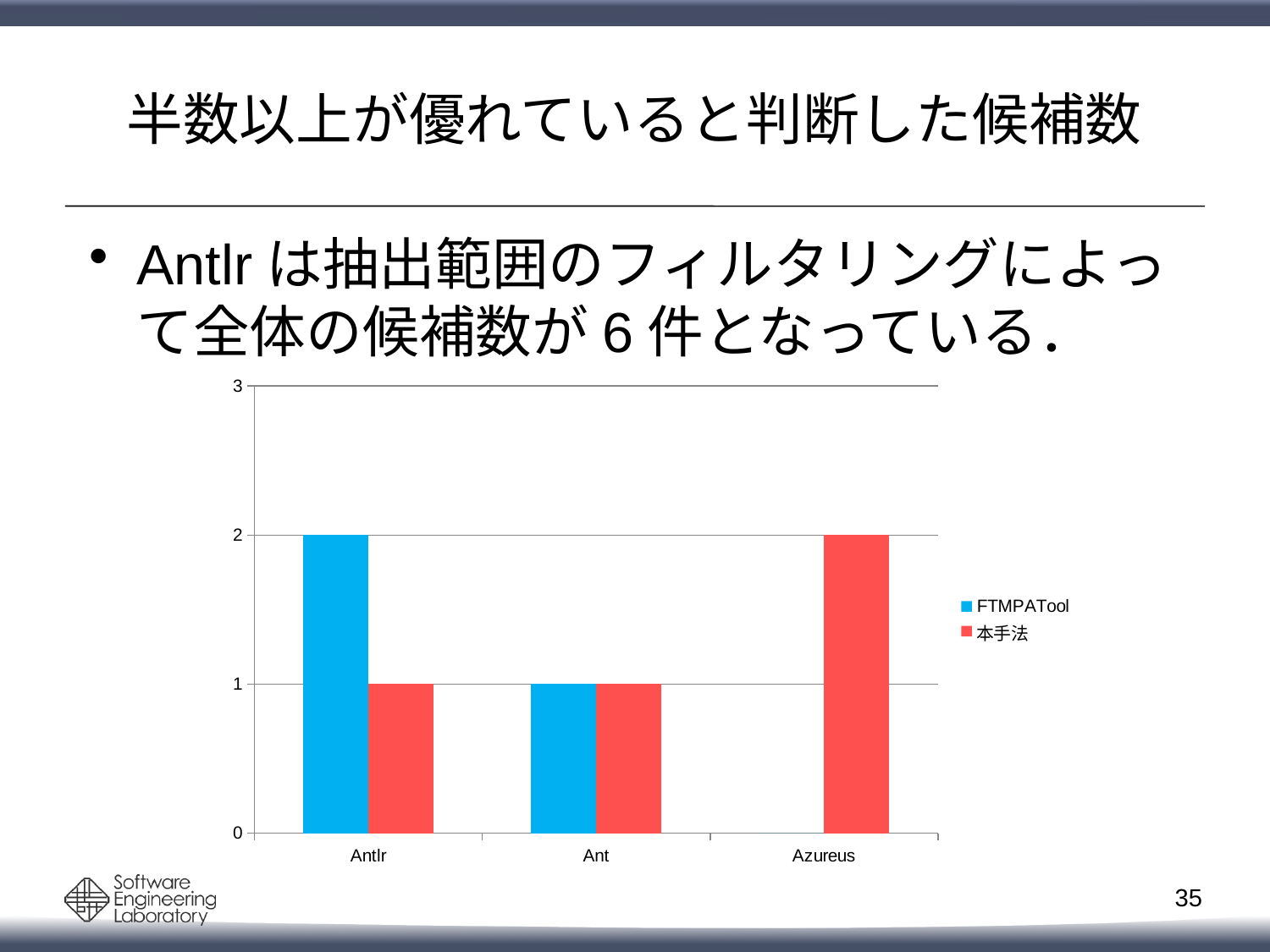
What kind of chart is shown on the slide? bar chart Which category has the highest value for 本手法? Azureus What is the value for 本手法 for Antlr? 1 What is the value for FTMPATool for Azureus? 0 Which category has the lowest value for FTMPATool? Azureus What is the value for FTMPATool for Antlr? 2 Which series is shown in red in the legend? 本手法 What is the value for FTMPATool for Ant? 1 What is the value for 本手法 for Azureus? 2 What is the difference between the FTMPATool value and the 本手法 value for Antlr? 1 How many series does the legend list? 2 How many categories are shown on the x axis? 3